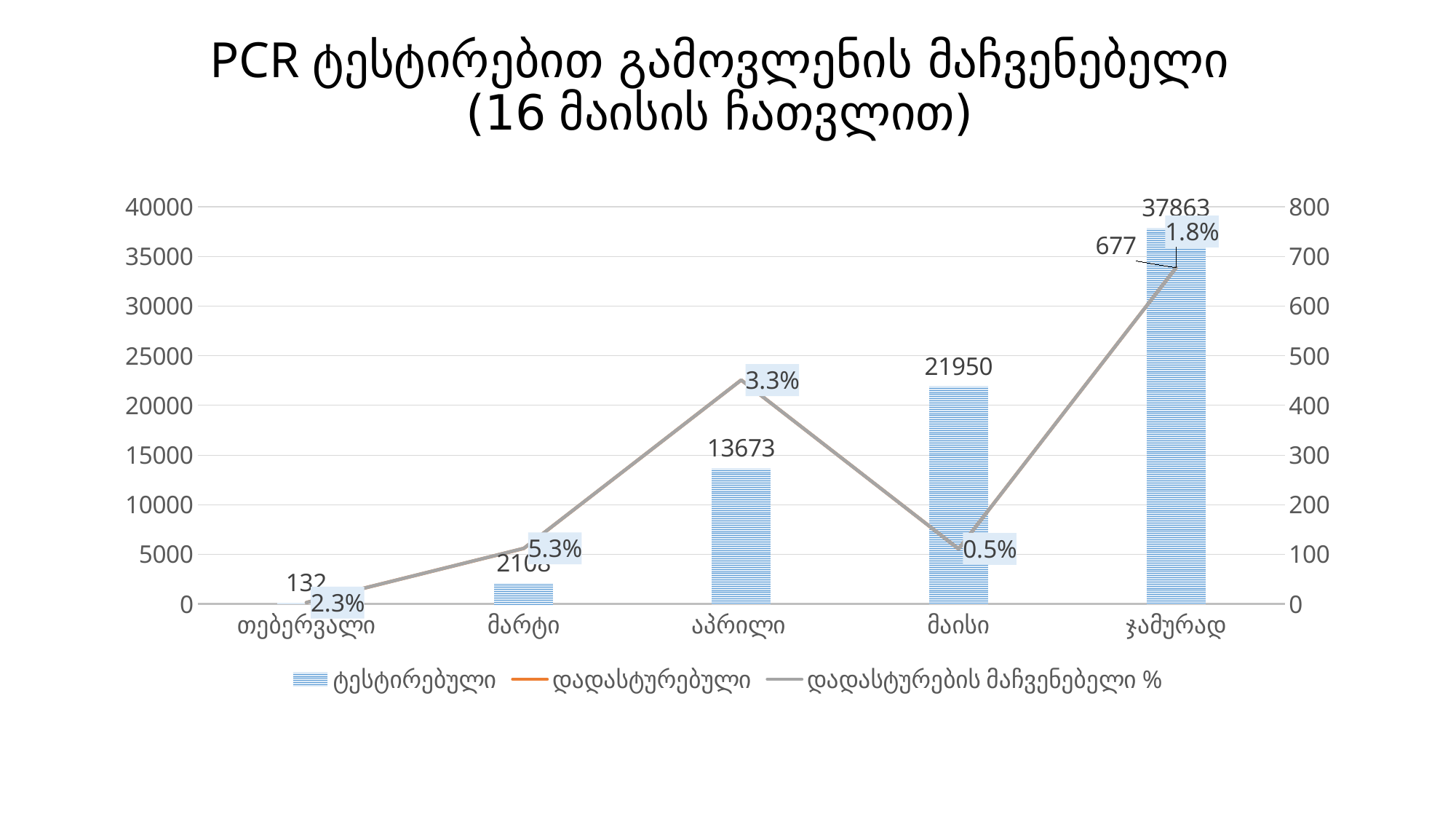
What is the ტესტირებული value for აპრილი? 13673 Which category has the highest დადასტურების მაჩვენებელი % value? მარტი What is the დადასტურების მაჩვენებელი % value for მაისი? 0.5% What is the difference between the ტესტირებული values for ჯამურად and მაისი? 15913 Which category has the highest ტესტირებული value? ჯამურად What is the ტესტირებული value for ჯამურად? 37863 How many categories are shown on the x axis? 5 What is the დადასტურების მაჩვენებელი % value for მარტი? 5.3% What is the ტესტირებული value for მაისი? 21950 Is the ტესტირებული value for აპრილი greater or less than 15000? less How many series does the legend list? 3 Which category has the lowest დადასტურების მაჩვენებელი % value? მაისი